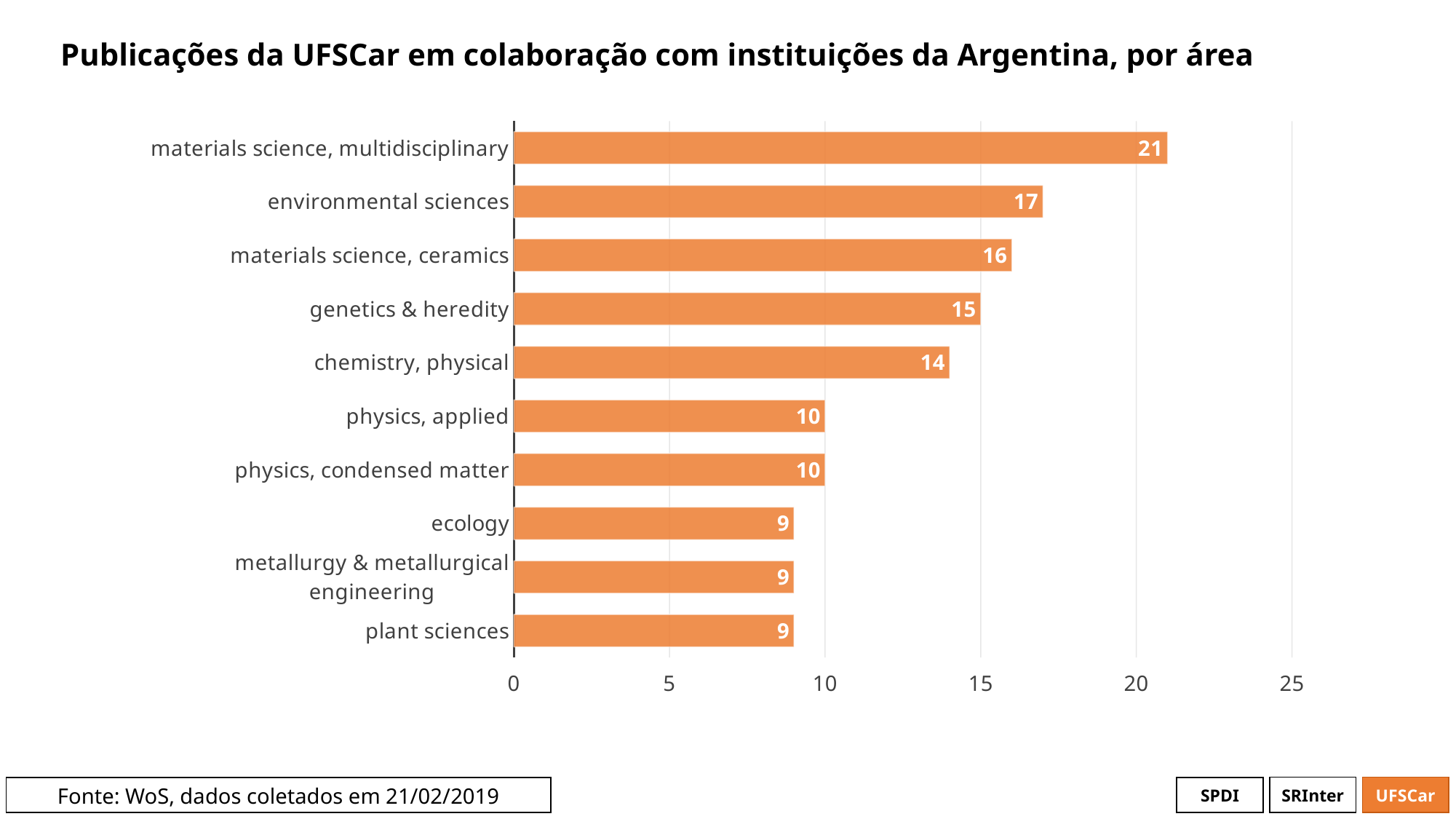
How many areas are shown in the chart? 10 What is the title of the chart? Publicações da UFSCar em colaboração com instituições da Argentina, por área What is the value for ecology? 9 What kind of chart is shown on the slide? bar chart What is the difference between environmental sciences and physics, applied? 7 What is the value for environmental sciences? 17 What is the value for chemistry, physical? 14 Which area has the highest value? materials science, multidisciplinary What is the value for genetics & heredity? 15 Is the value for materials science, ceramics greater or less than 15? greater What is the difference between materials science, multidisciplinary and materials science, ceramics? 5 Which is larger, genetics & heredity or chemistry, physical? genetics & heredity